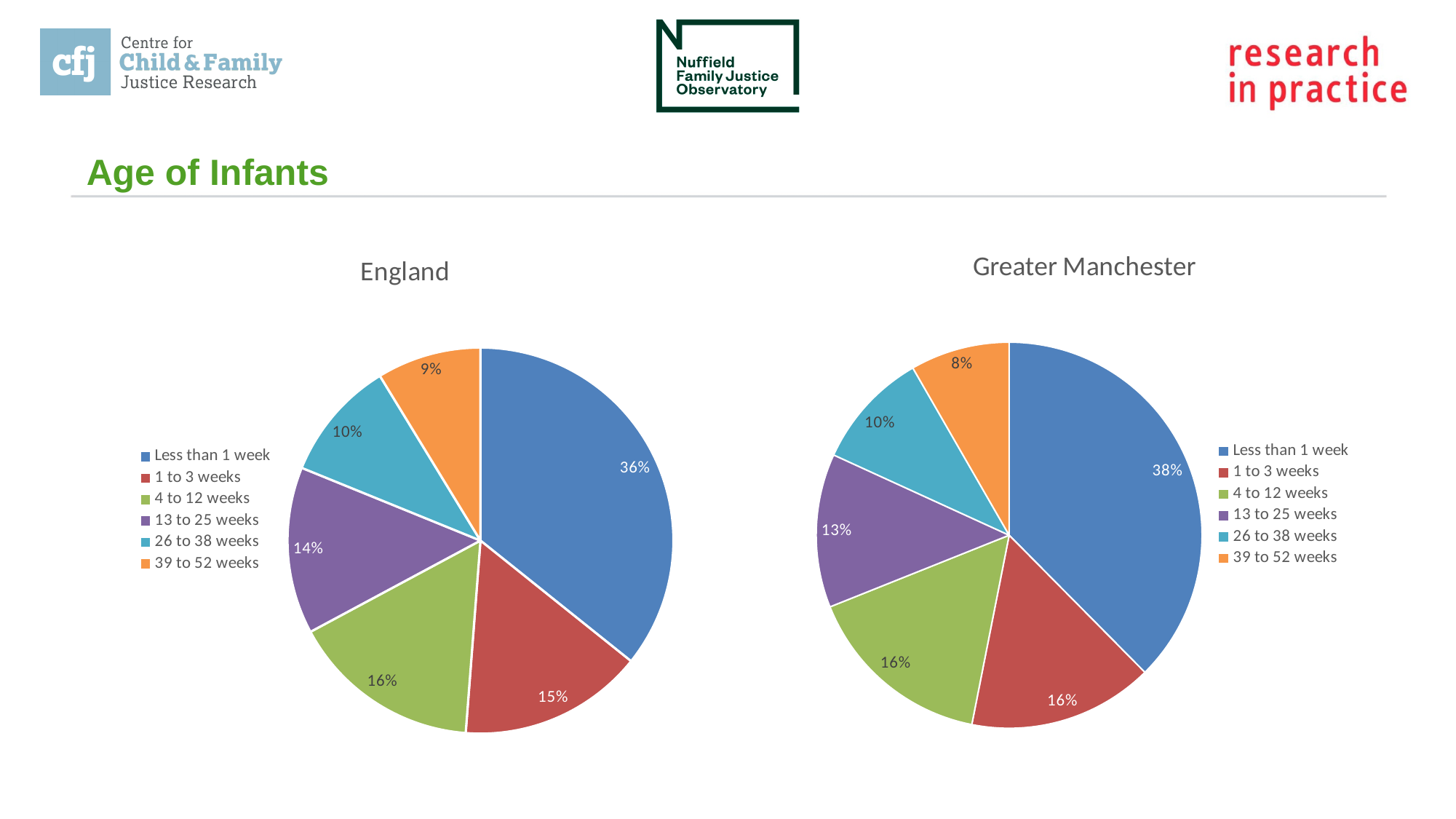
In the Greater Manchester pie chart, which age category has the smallest share? 39 to 52 weeks In the England pie chart, what percentage of infants are less than 1 week old? 36% In the England pie chart, which is larger: the share for 13 to 25 weeks or the share for 26 to 38 weeks? 13 to 25 weeks In the Greater Manchester pie chart, which age category has the largest share? Less than 1 week In the Greater Manchester pie chart, what percentage of infants are 1 to 3 weeks old? 16% What is the difference in percentage points between the 'Less than 1 week' share in the Greater Manchester chart and in the England chart? 2 percentage points In the England pie chart, which age category has the smallest share? 39 to 52 weeks In the England pie chart, what percentage of infants are 39 to 52 weeks old? 9% What is the title of the pie chart on the right side of the slide? Greater Manchester What type of chart is used for the Greater Manchester data? Pie chart In the Greater Manchester pie chart, what percentage of infants are 13 to 25 weeks old? 13% How many age categories does the legend of the England pie chart list? 6